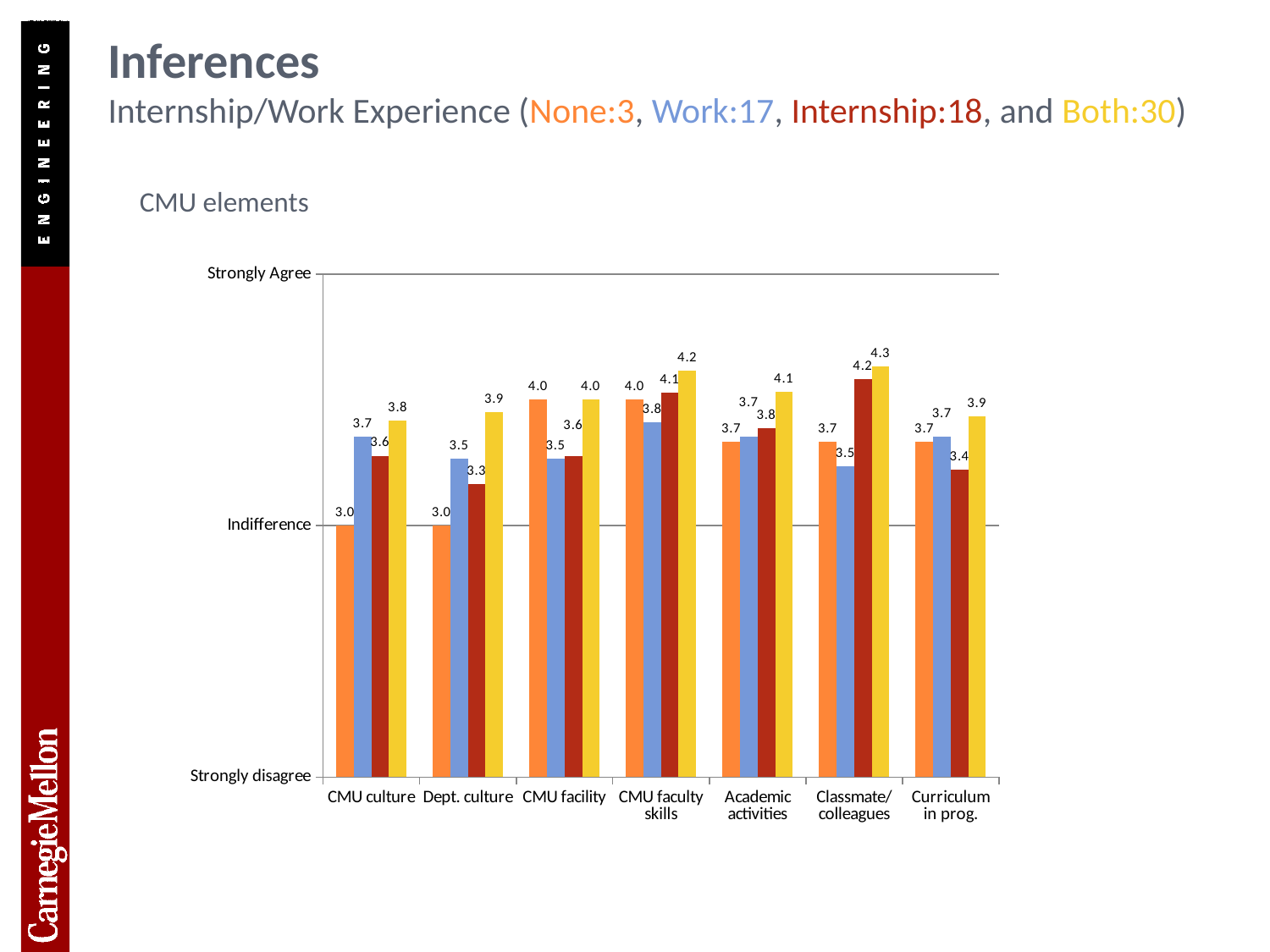
Which is larger for CMU facility: the orange (None) bar or the blue (Work) bar? the orange (None) bar What is the value of the orange (None) bar for CMU culture? 3.0 What is the value of the yellow (Both) bar for Classmate/colleagues? 4.3 How many bars are shown for each category? 4 What is the label of the middle tick on the y axis? Indifference What is the value of the blue (Work) bar for CMU faculty skills? 3.8 Which category has the highest yellow (Both) bar? Classmate/colleagues What is the value of the dark red (Internship) bar for Dept. culture? 3.3 How many categories are shown on the x axis? 7 Which category has the lowest dark red (Internship) bar? Dept. culture What is the difference between the yellow (Both) bar and the orange (None) bar for Dept. culture? 0.9 What kind of chart is shown on the slide? bar chart